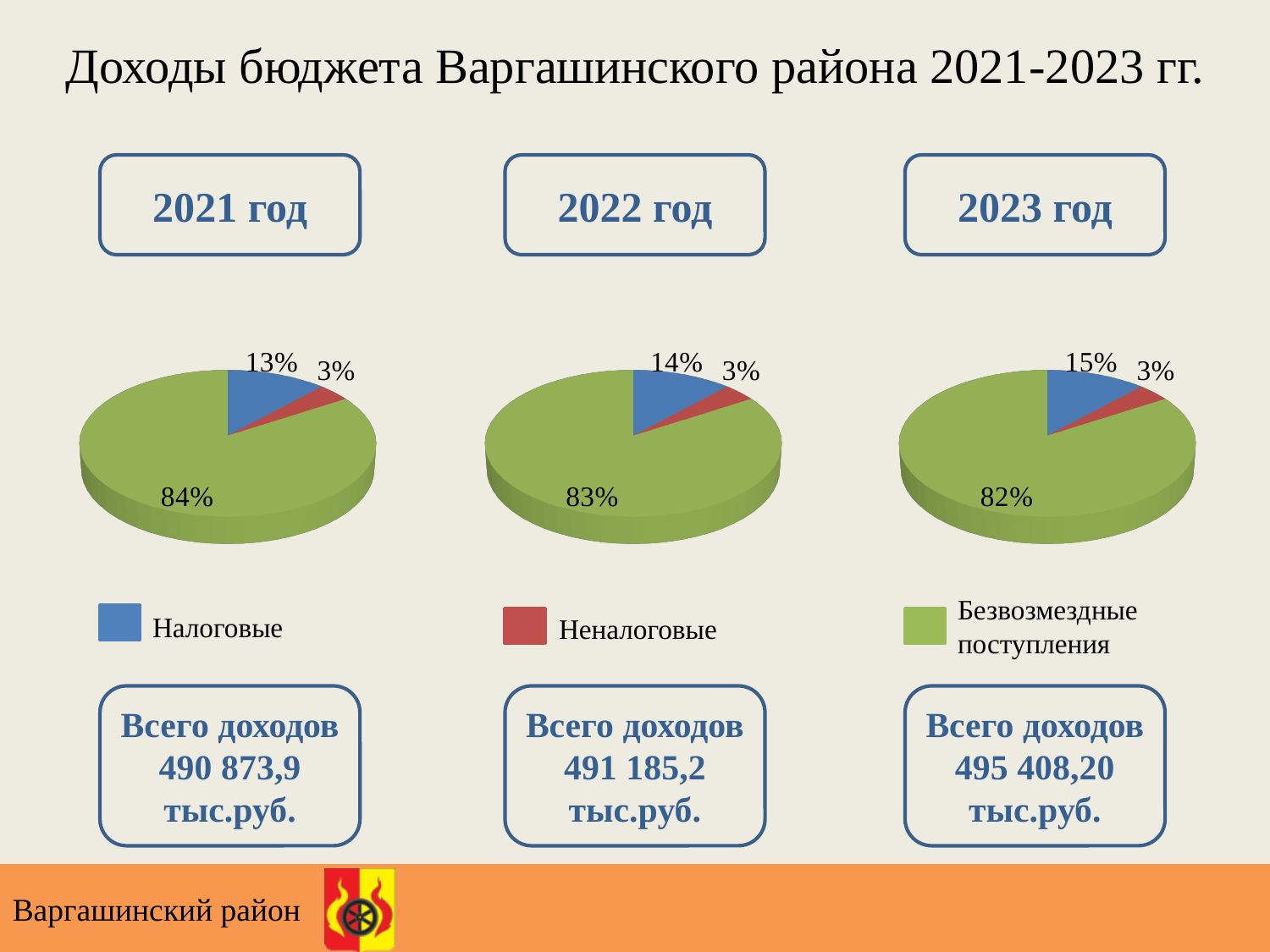
In the 2021 год pie chart, what share is labelled for Налоговые? 13% What type of chart is used for each year on the slide? Pie chart In the 2022 год pie chart, which category has the smallest slice? Неналоговые In the 2023 год pie chart, what share is labelled for Налоговые? 15% Across the three pie charts from 2021 to 2023, does the Налоговые share rise or fall? Rise In the 2022 год pie chart, what share is labelled for Безвозмездные поступления? 83% Which is larger in the 2021 год pie chart: the Налоговые slice or the Неналоговые slice? Налоговые In the 2023 год pie chart, what is the difference between the Безвозмездные поступления share and the Налоговые share? 67% In the 2023 год pie chart, what share is labelled for Неналоговые? 3% In the 2021 год pie chart, which category has the largest slice? Безвозмездные поступления How many slices does the 2022 год pie chart have? 3 What colour represents Безвозмездные поступления in the legend? Green